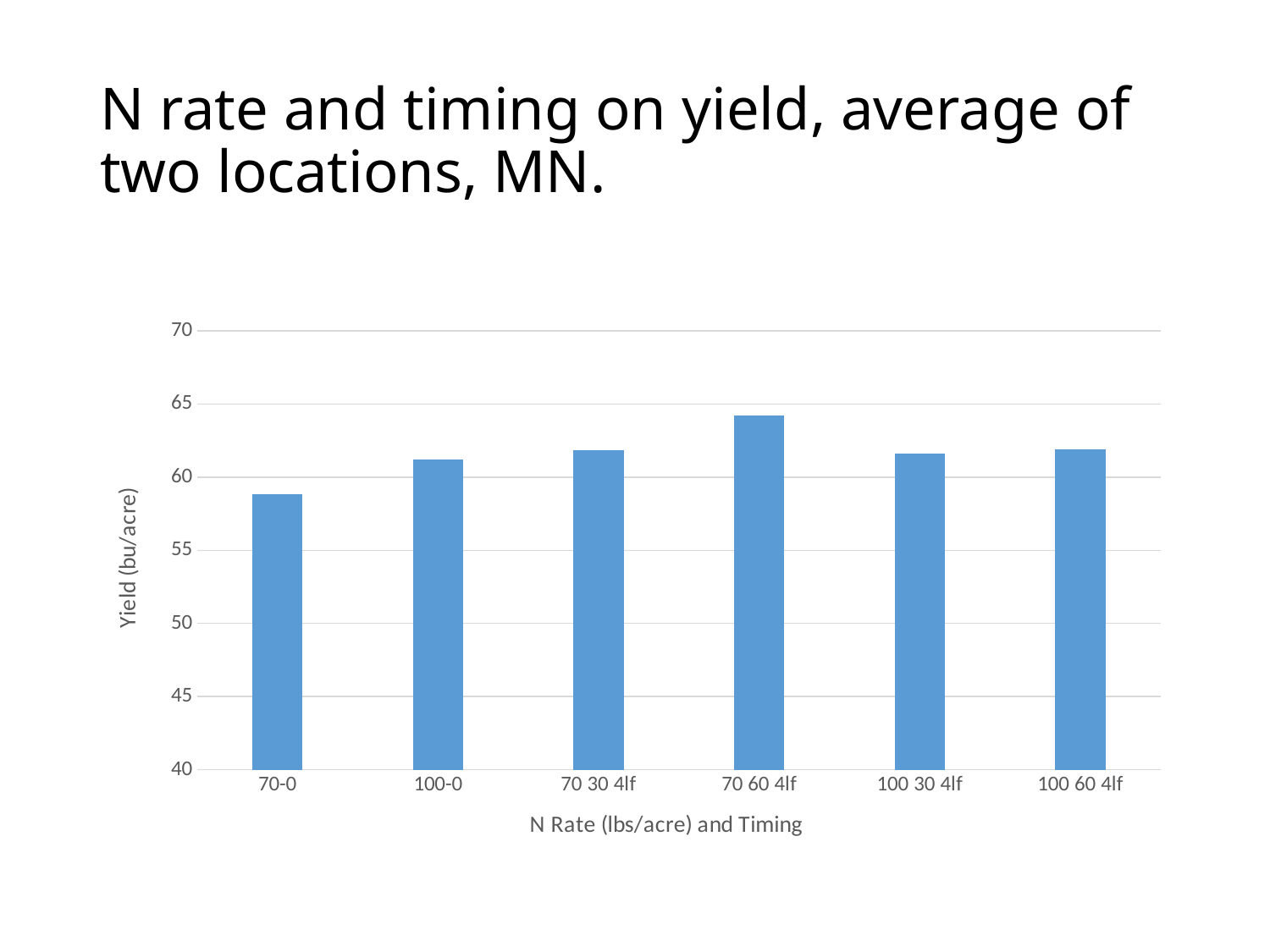
Is the yield for 70 60 4lf greater or less than 65 bu/acre? less Is the yield for 100-0 greater or less than 60 bu/acre? greater Is the yield for 100 60 4lf greater or less than 65 bu/acre? less Which N rate and timing category has the highest yield? 70 60 4lf How many N rate and timing categories are plotted on the chart? 6 What kind of chart is shown on the slide? bar chart What is the label of the horizontal axis of the chart? N Rate (lbs/acre) and Timing Which has the higher yield, 70 60 4lf or 100 30 4lf? 70 60 4lf What is the label of the vertical axis of the chart? Yield (bu/acre) Which has the higher yield, 70-0 or 100-0? 100-0 Which N rate and timing category has the lowest yield? 70-0